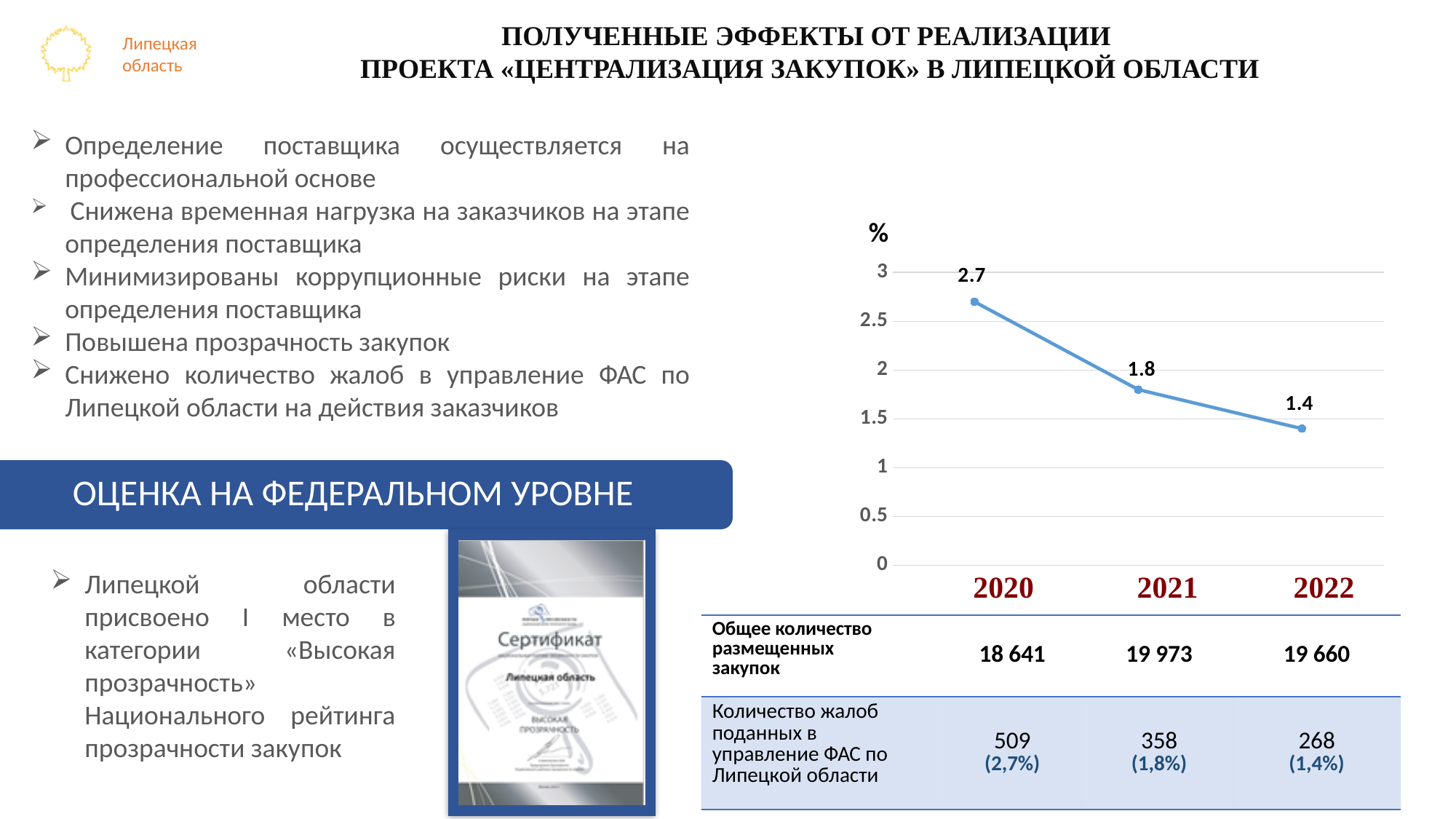
What is the value plotted for 2020 on the line chart? 2.7 How many data points are plotted on the line chart? 3 Do the values on the line chart rise or fall from 2020 to 2022? fall What is the value plotted for 2021 on the line chart? 1.8 Which year has the highest value on the line chart? 2020 What is the value plotted for 2022 on the line chart? 1.4 What is the difference between the 2020 and 2022 values on the line chart? 1.3 Which year has the lowest value on the line chart? 2022 What type of chart is shown on the slide? line chart What is the difference between the 2020 and 2021 values on the line chart? 0.9 What unit label is shown above the vertical axis of the line chart? % Which is larger on the line chart, the value for 2021 or the value for 2022? 2021